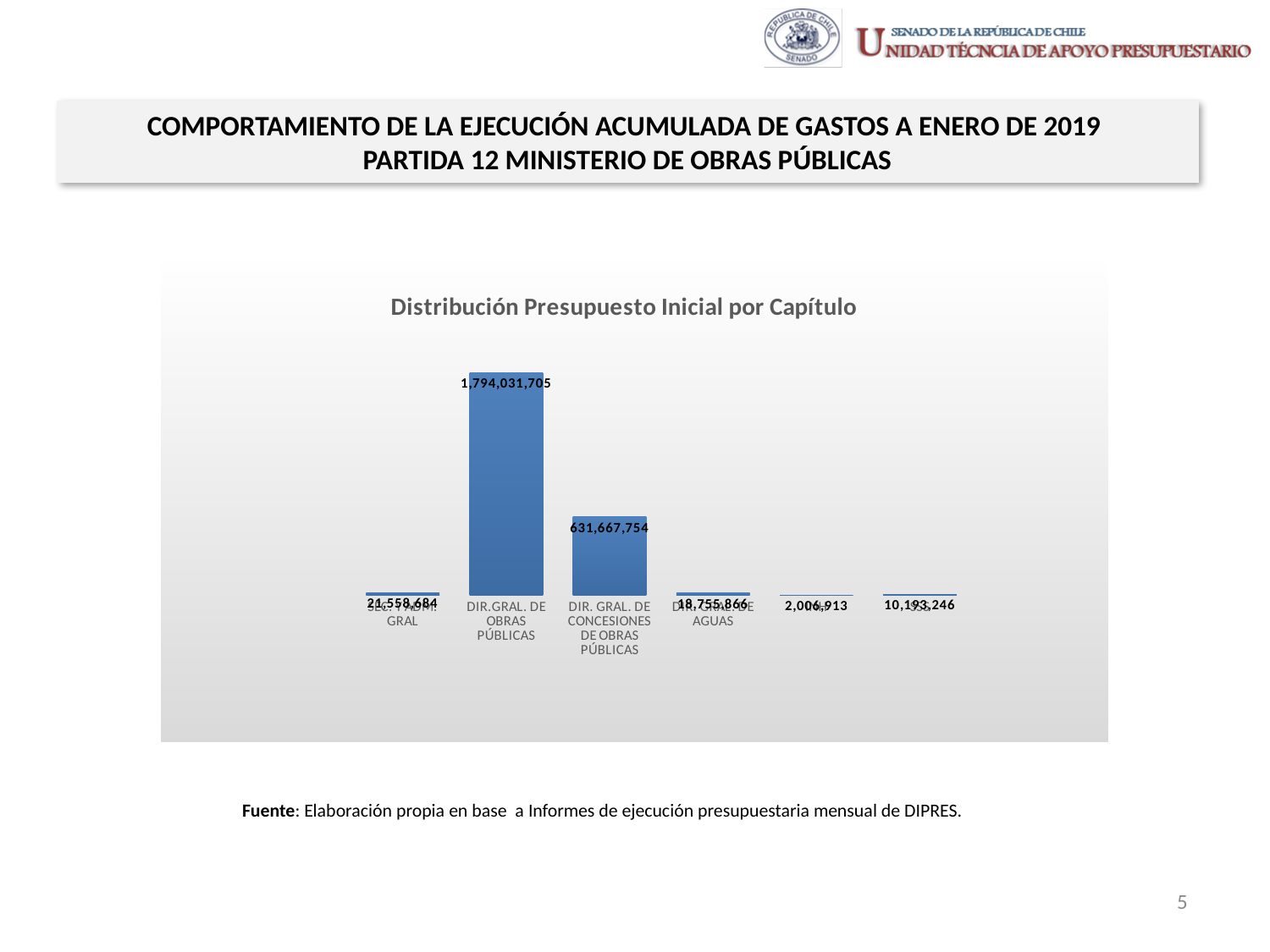
What kind of chart is shown on the slide? Bar chart What is the second-highest value shown in the chart? 631,667,754 Which category has the highest value in the chart? DIR.GRAL. DE OBRAS PÚBLICAS What is the value for DIR. GRAL. DE CONCESIONES DE OBRAS PÚBLICAS? 631,667,754 What is the highest value shown in the chart? 1,794,031,705 What is the difference between the values for DIR.GRAL. DE OBRAS PÚBLICAS and DIR. GRAL. DE CONCESIONES DE OBRAS PÚBLICAS? 1,162,363,951 Which is larger, the value for DIR.GRAL. DE OBRAS PÚBLICAS or the value for DIR. GRAL. DE CONCESIONES DE OBRAS PÚBLICAS? DIR.GRAL. DE OBRAS PÚBLICAS What is the lowest value shown in the chart? 2,006,913 What is the value for DIR.GRAL. DE OBRAS PÚBLICAS in the chart? 1,794,031,705 How many bars are plotted in the chart? 6 What is the title of the chart? Distribución Presupuesto Inicial por Capítulo